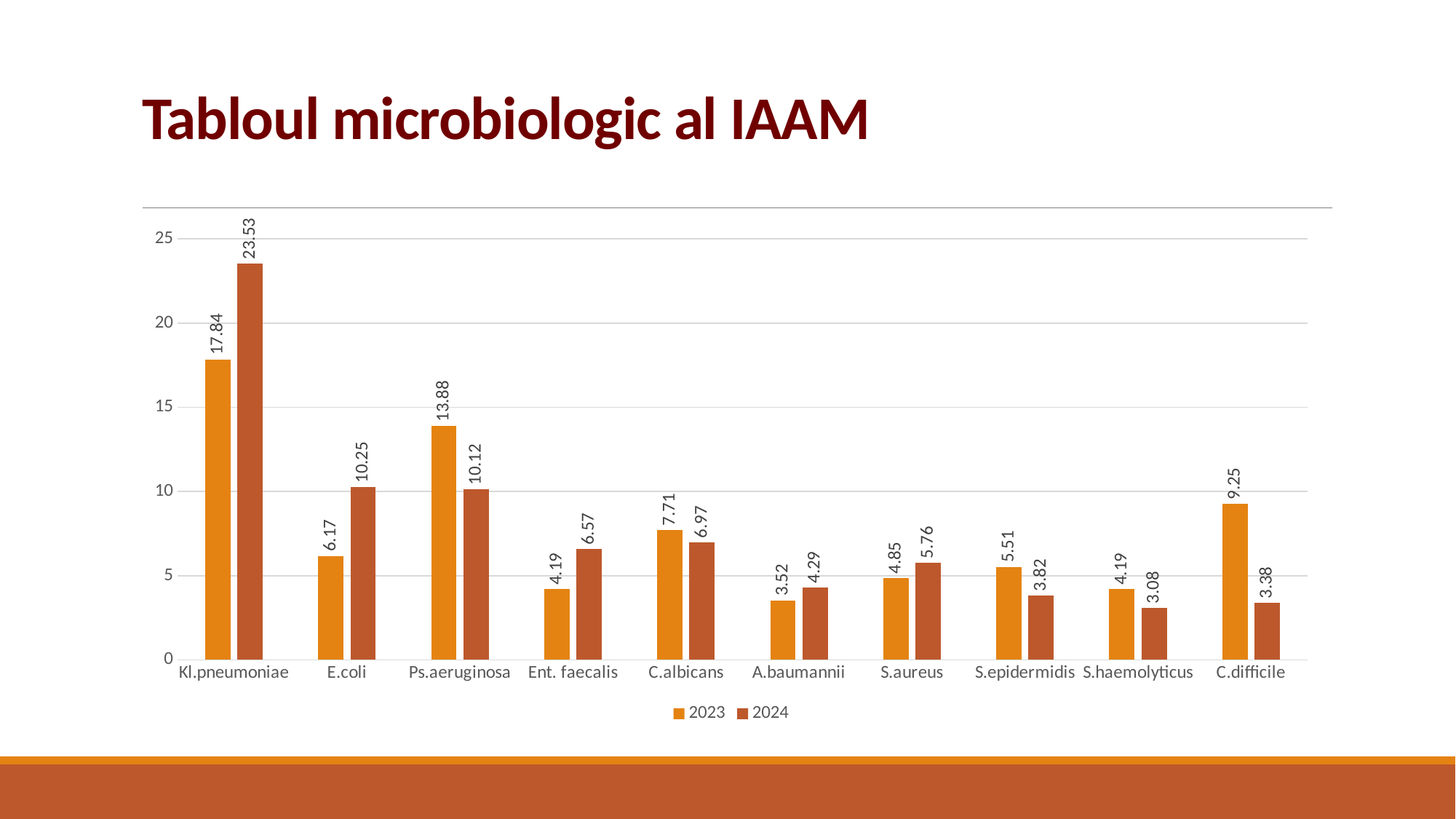
Which is larger for E.coli, the 2023 value or the 2024 value? 2024 What is the difference between the 2024 and 2023 values for Kl.pneumoniae? 5.69 Is the 2023 value for C.albicans greater or less than 10? less How many categories are shown on the x axis? 10 What is the 2024 value for Kl.pneumoniae? 23.53 What is the 2024 value for S.haemolyticus? 3.08 What is the 2023 value for Ps.aeruginosa? 13.88 How many series does the legend list? 2 Which category has the lowest 2024 value? S.haemolyticus What kind of chart is shown on the slide? bar chart What is the difference between the 2023 and 2024 values for C.difficile? 5.87 Which category has the highest 2023 value? Kl.pneumoniae